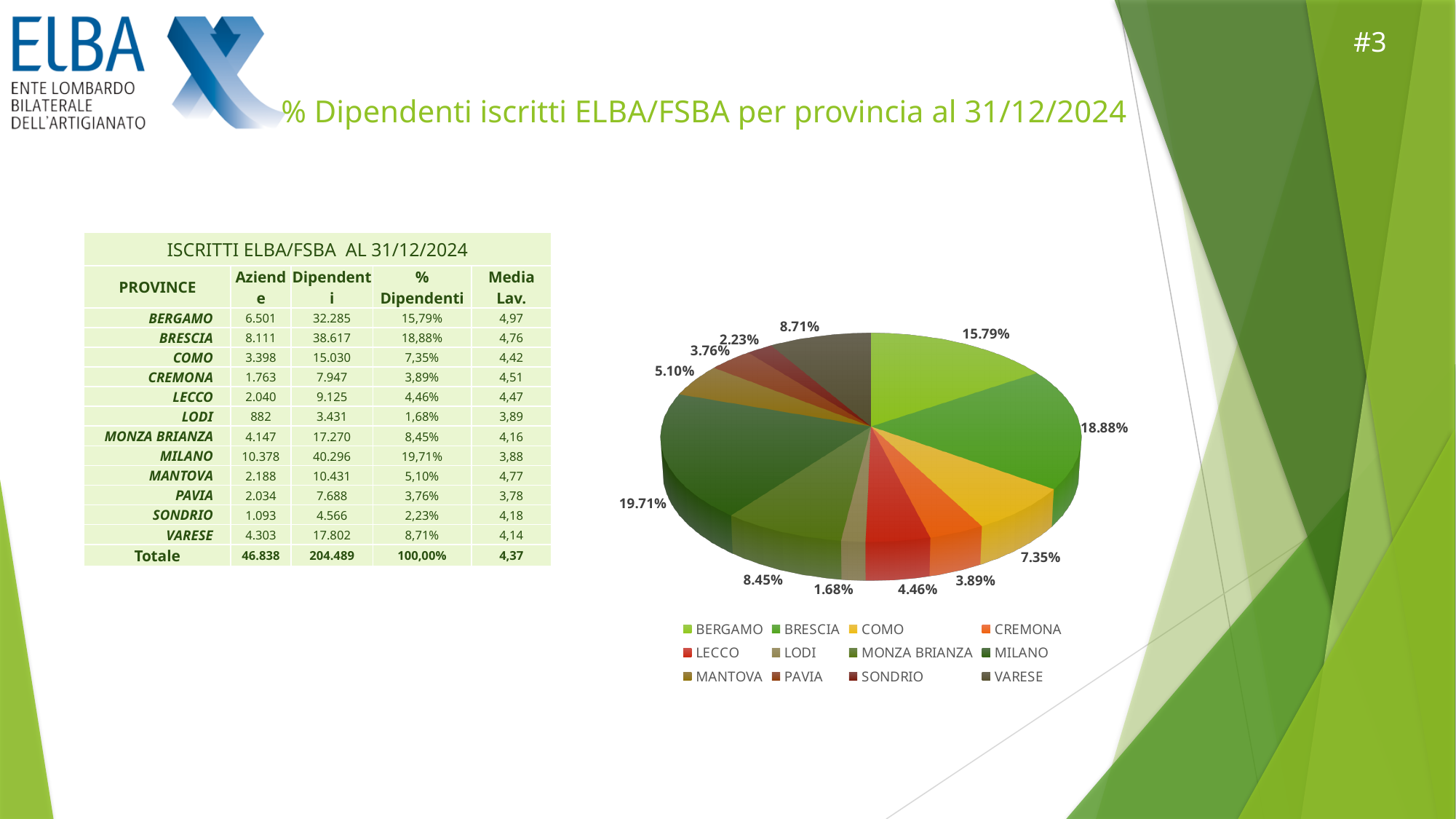
Which has a larger share in the pie chart, COMO or MONZA BRIANZA? MONZA BRIANZA How many entries does the legend of the pie chart list? 12 What is the percentage shown for BRESCIA in the pie chart? 18.88% What type of chart is shown on the slide? pie chart What is the title of the slide containing the pie chart? % Dipendenti iscritti ELBA/FSBA per provincia al 31/12/2024 What is the percentage shown for VARESE in the pie chart? 8.71% Which province has the largest slice in the pie chart? MILANO What is the percentage shown for LODI in the pie chart? 1.68% What is the percentage shown for MILANO in the pie chart? 19.71% How many provinces (slices) are shown in the pie chart? 12 What is the difference in percentage points between BRESCIA and BERGAMO in the pie chart? 3.09 Which province has the smallest slice in the pie chart? LODI